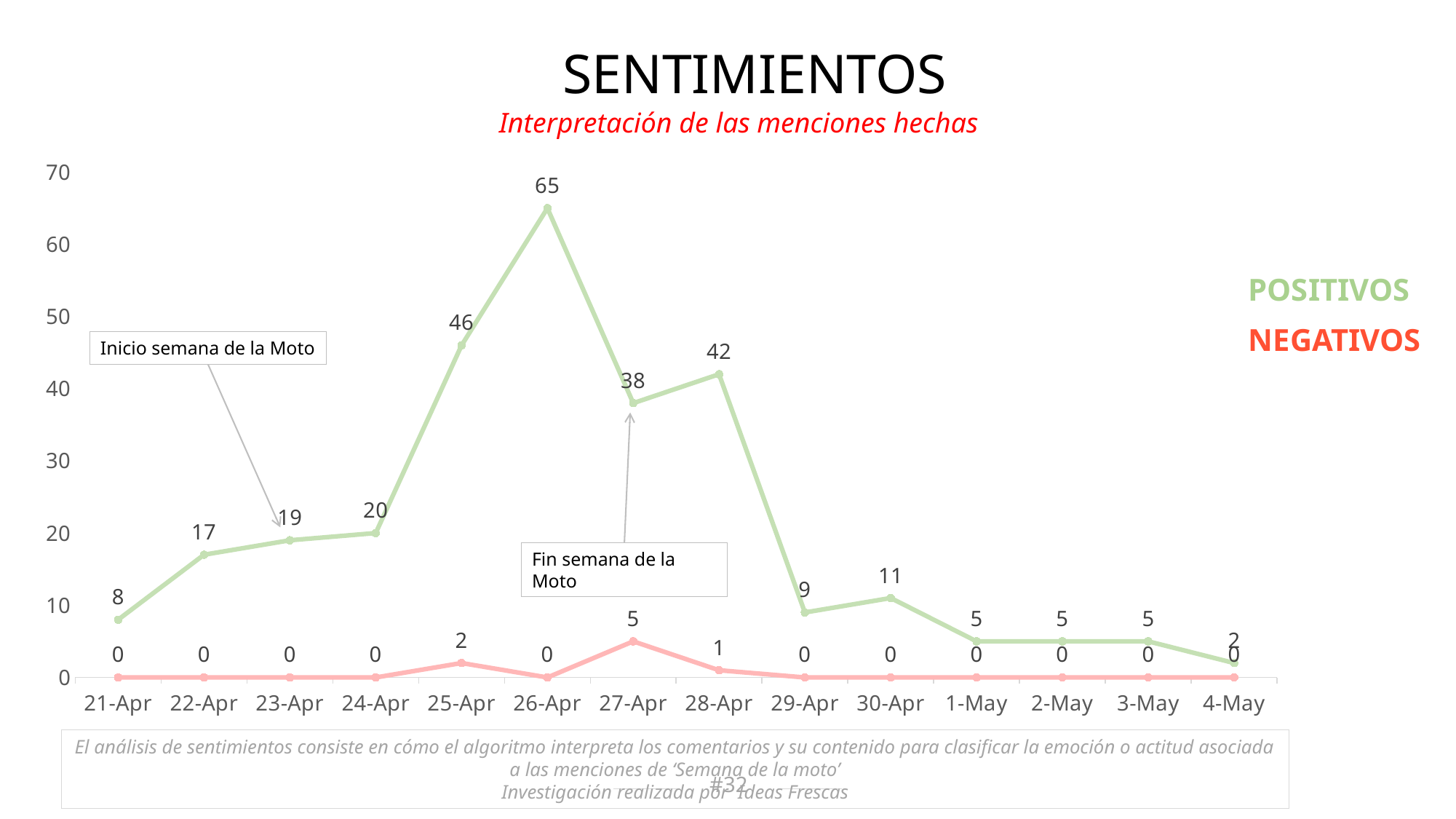
What is the POSITIVOS value on 26-Apr? 65 What kind of chart is shown on the slide? Line chart On which date does the POSITIVOS series reach its highest value? 26-Apr How many series does the legend list? 2 What is the difference between the POSITIVOS values on 26-Apr and 27-Apr? 27 Which is larger, the POSITIVOS value on 25-Apr or on 28-Apr? 25-Apr Which colour is used for the NEGATIVOS series? Red What is the NEGATIVOS value on 27-Apr? 5 How many dates are shown on the x axis? 14 Does the POSITIVOS series rise or fall from 28-Apr to 29-Apr? Fall On which date does the POSITIVOS series have its lowest value? 4-May What is the POSITIVOS value on 21-Apr? 8